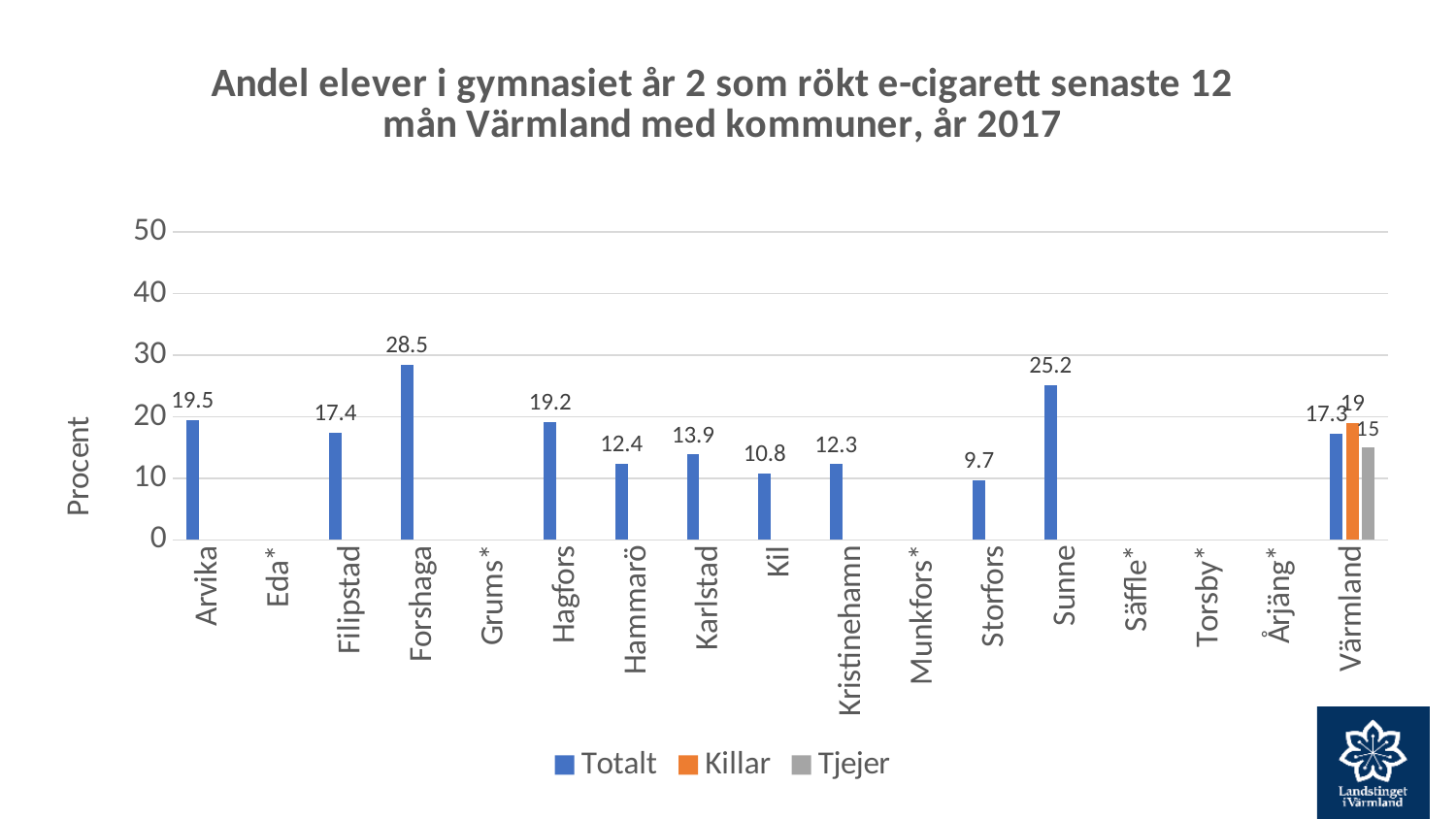
What kind of chart is shown on the slide? Bar chart How many series does the legend list? 3 What is the Killar value for Värmland? 19 Is the Totalt value for Kil greater or less than 20? less Which municipality has the highest Totalt value? Forshaga Which has a higher Totalt value, Hagfors or Filipstad? Hagfors Which municipality with a plotted bar has the lowest Totalt value? Storfors What is the Tjejer value for Värmland? 15 What is the Totalt value for Forshaga? 28.5 What is the difference between the Totalt values for Sunne and Arvika? 5.7 What is the label on the vertical axis? Procent What is the Totalt value for Storfors? 9.7